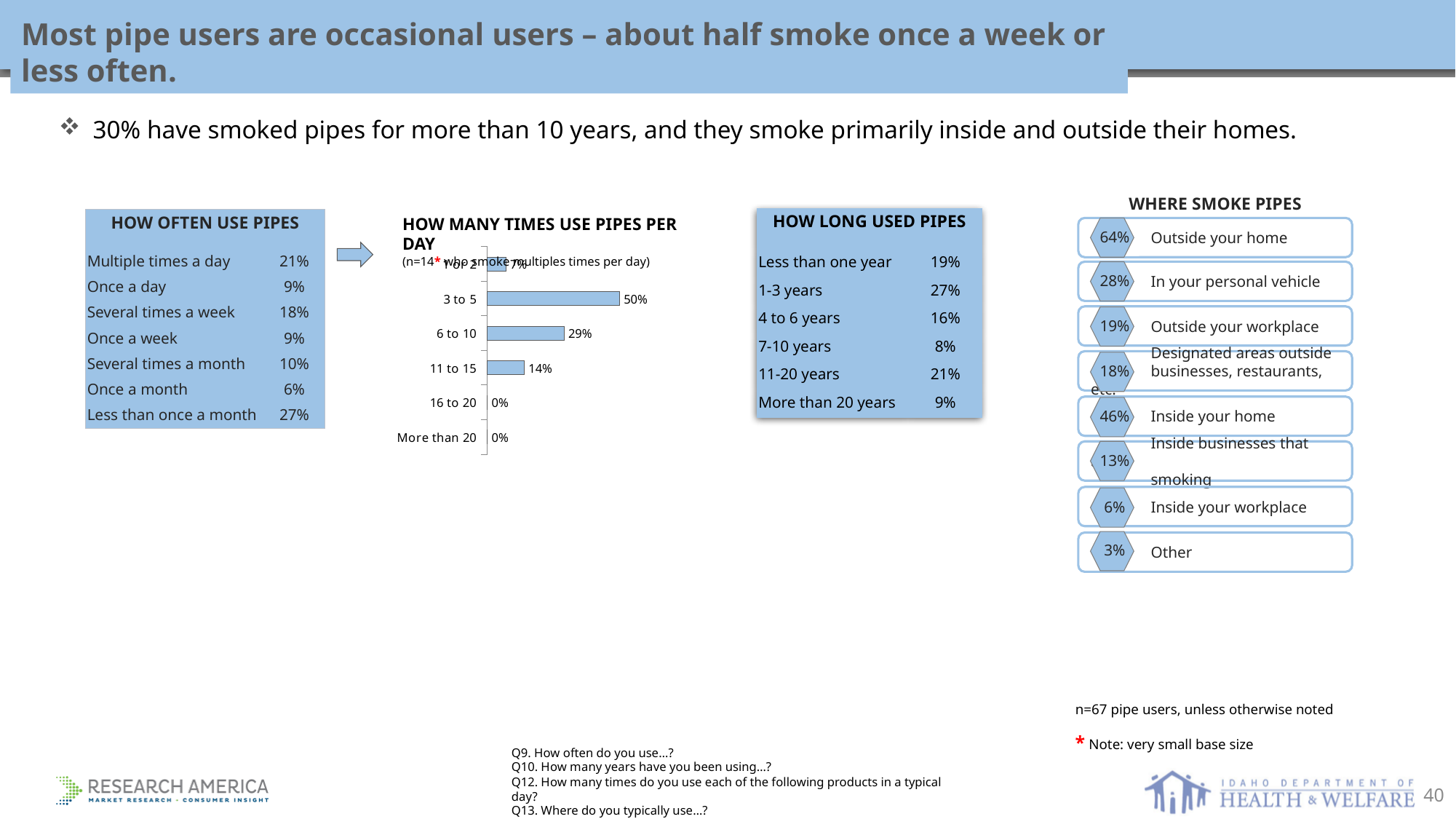
How many categories are shown in the 'How many times use pipes per day' chart? 6 In the 'How many times use pipes per day' chart, what is the difference between the values for 6 to 10 and 11 to 15? 15% In the 'How many times use pipes per day' chart, what is the difference between the values for 3 to 5 and 6 to 10? 21% In the 'How many times use pipes per day' chart, what is the value for 3 to 5? 50% In the 'How many times use pipes per day' chart, what is the value for 6 to 10? 29% In the 'How many times use pipes per day' chart, what is the value for More than 20? 0% What is the sample size noted under the title of the 'How many times use pipes per day' chart? n=14 In the 'How many times use pipes per day' chart, what is the value for 16 to 20? 0% In the 'How many times use pipes per day' chart, which category has the highest value? 3 to 5 In the 'How many times use pipes per day' chart, what is the value for 11 to 15? 14% In the 'How many times use pipes per day' chart, which is larger, the value for 6 to 10 or the value for 11 to 15? 6 to 10 What kind of chart is the 'How many times use pipes per day' chart? Bar chart